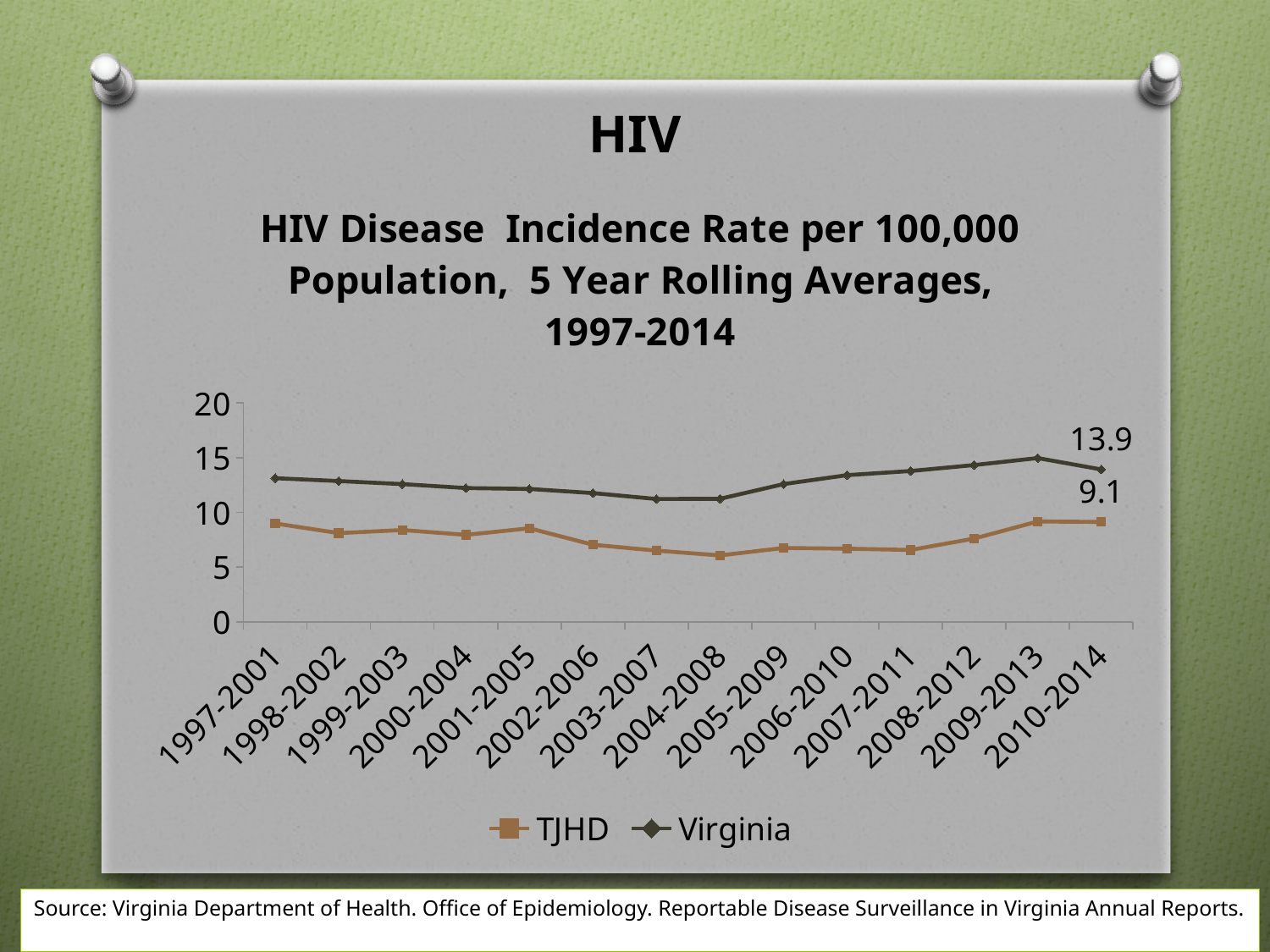
What is the TJHD HIV disease incidence rate for 2010-2014? 9.1 What kind of chart is shown on the slide? line chart What is the difference between the Virginia and TJHD rates for 2010-2014? 4.8 Which series has the higher rate in 2010-2014, TJHD or Virginia? Virginia What is the Virginia HIV disease incidence rate for 2010-2014? 13.9 How many series does the legend list? 2 Does the TJHD line rise or fall from 1997-2001 to 2004-2008? fall How many 5-year periods are shown on the x axis? 14 Is the TJHD value for 2004-2008 greater or less than 10? less Is the Virginia value for 1997-2001 greater or less than 10? greater Does the Virginia line rise or fall from 2004-2008 to 2009-2013? rise Which series is drawn in orange with square markers? TJHD